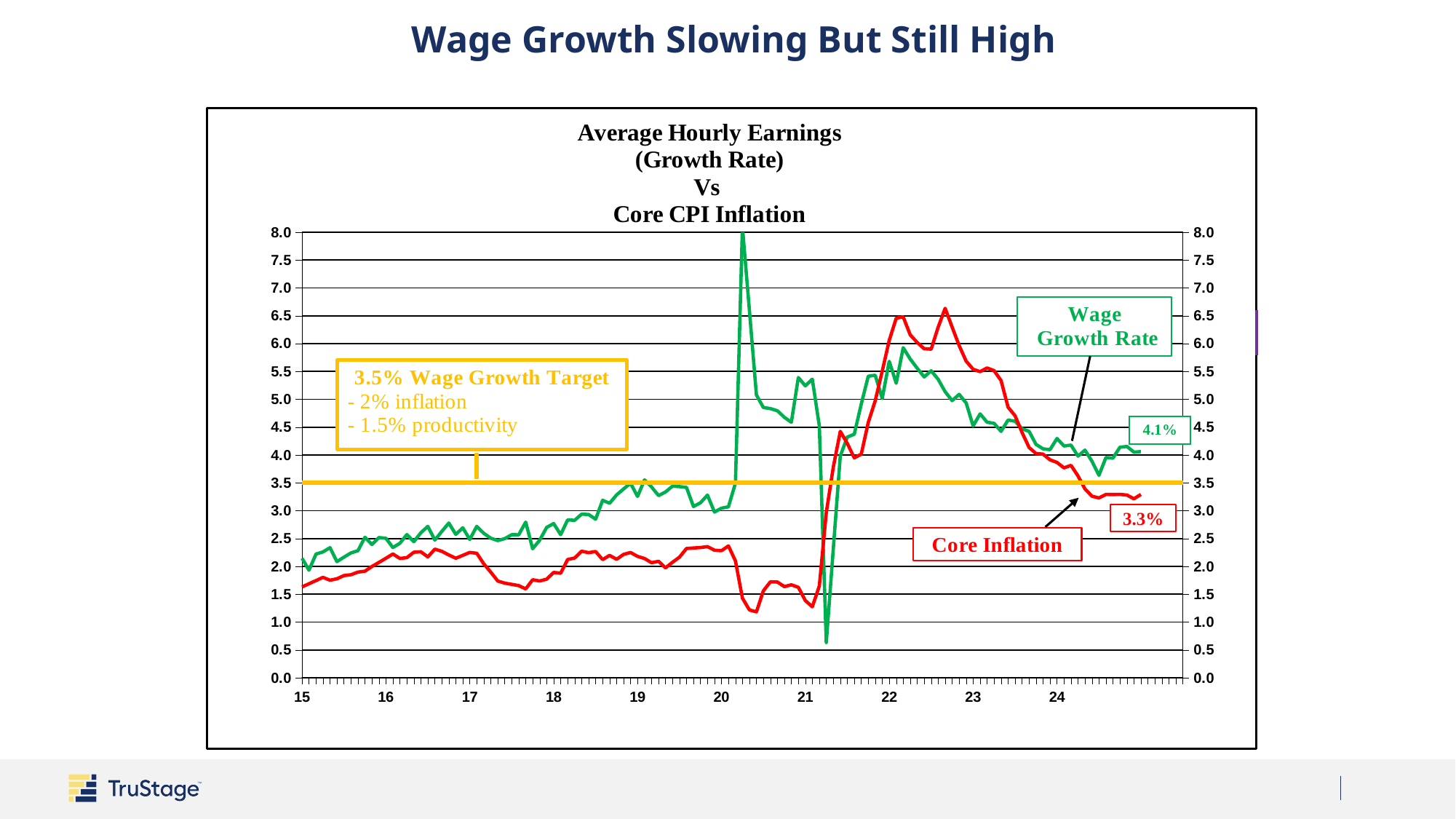
What kind of chart is shown on the slide? line chart What colour is the Wage Growth Rate line? green What is the latest labelled value of the Core Inflation line? 3.3% Which is larger at the end of the chart, the Wage Growth Rate or Core Inflation? Wage Growth Rate What is the difference between the latest labelled Wage Growth Rate (4.1%) and the latest labelled Core Inflation (3.3%)? 0.8% Is the peak of the Core Inflation line in 2022 greater or less than 6.0? greater Is the latest Wage Growth Rate value of 4.1% greater or less than the 3.5% target? greater What is the latest labelled value of the Wage Growth Rate line? 4.1% Is the peak of the Wage Growth Rate line in 2020 greater or less than 7.0? greater What is the value of the horizontal Wage Growth Target line? 3.5% Is the lowest point of the Core Inflation line in 2020 greater or less than 1.5? less Does the Wage Growth Rate line rise or fall from 2022 to 2024? fall